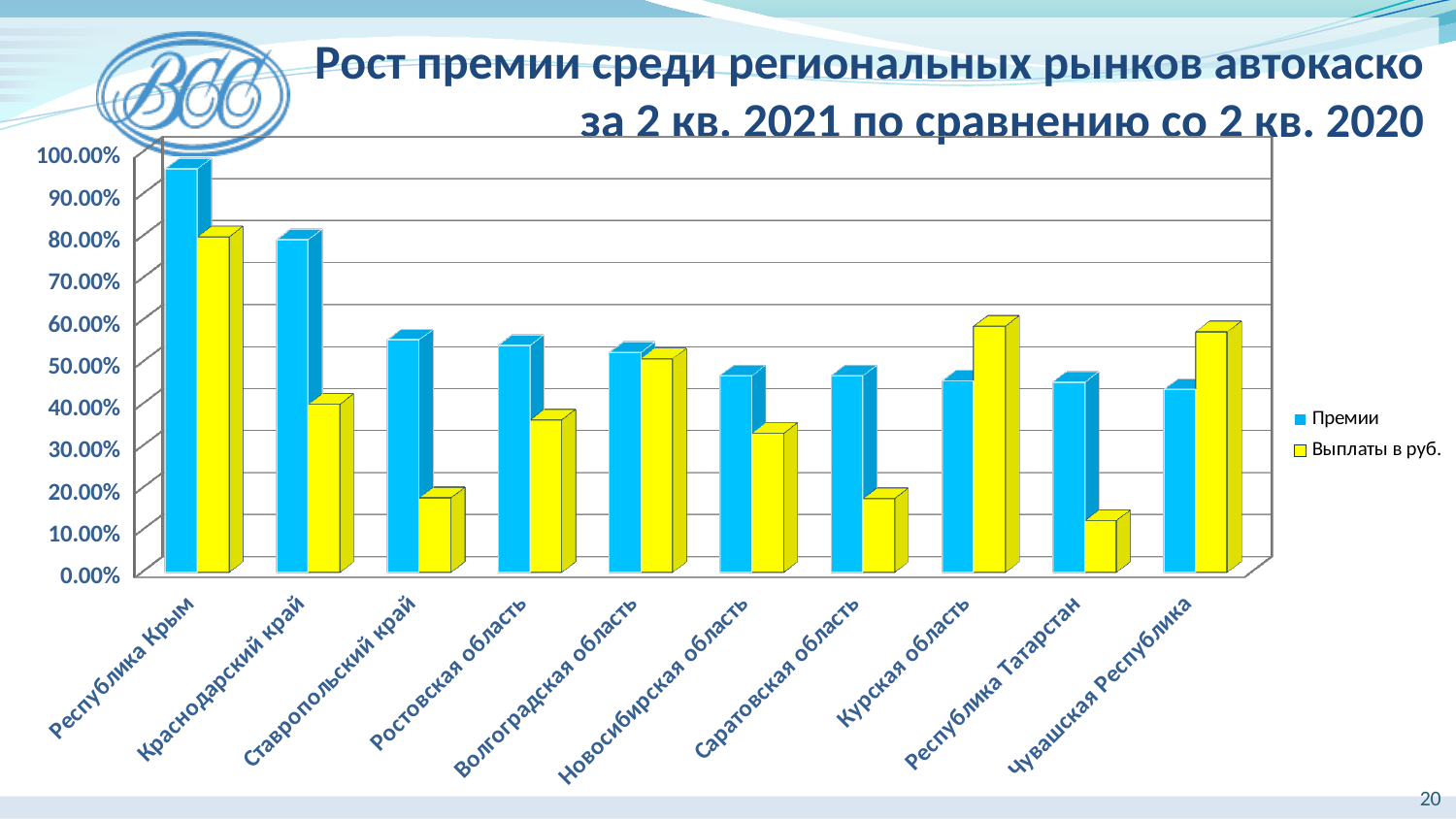
Is the Выплаты в руб. value for Ставропольский край greater or less than 20.00%? less How many series does the chart legend list? 2 Which region has the highest value for Выплаты в руб.? Республика Крым Is the Выплаты в руб. value for Курская область greater or less than 50.00%? greater Is the Премии value for Республика Крым greater or less than 90.00%? greater For Курская область, which is larger: Премии or Выплаты в руб.? Выплаты в руб. Which region has the highest value for Премии? Республика Крым For Краснодарский край, which is larger: Премии or Выплаты в руб.? Премии Do the Премии values generally rise or fall from left to right across the regions? Fall What kind of chart is shown on the slide? Bar chart How many regions are shown on the x axis of the chart? 10 Which region has the lowest value for Выплаты в руб.? Республика Татарстан